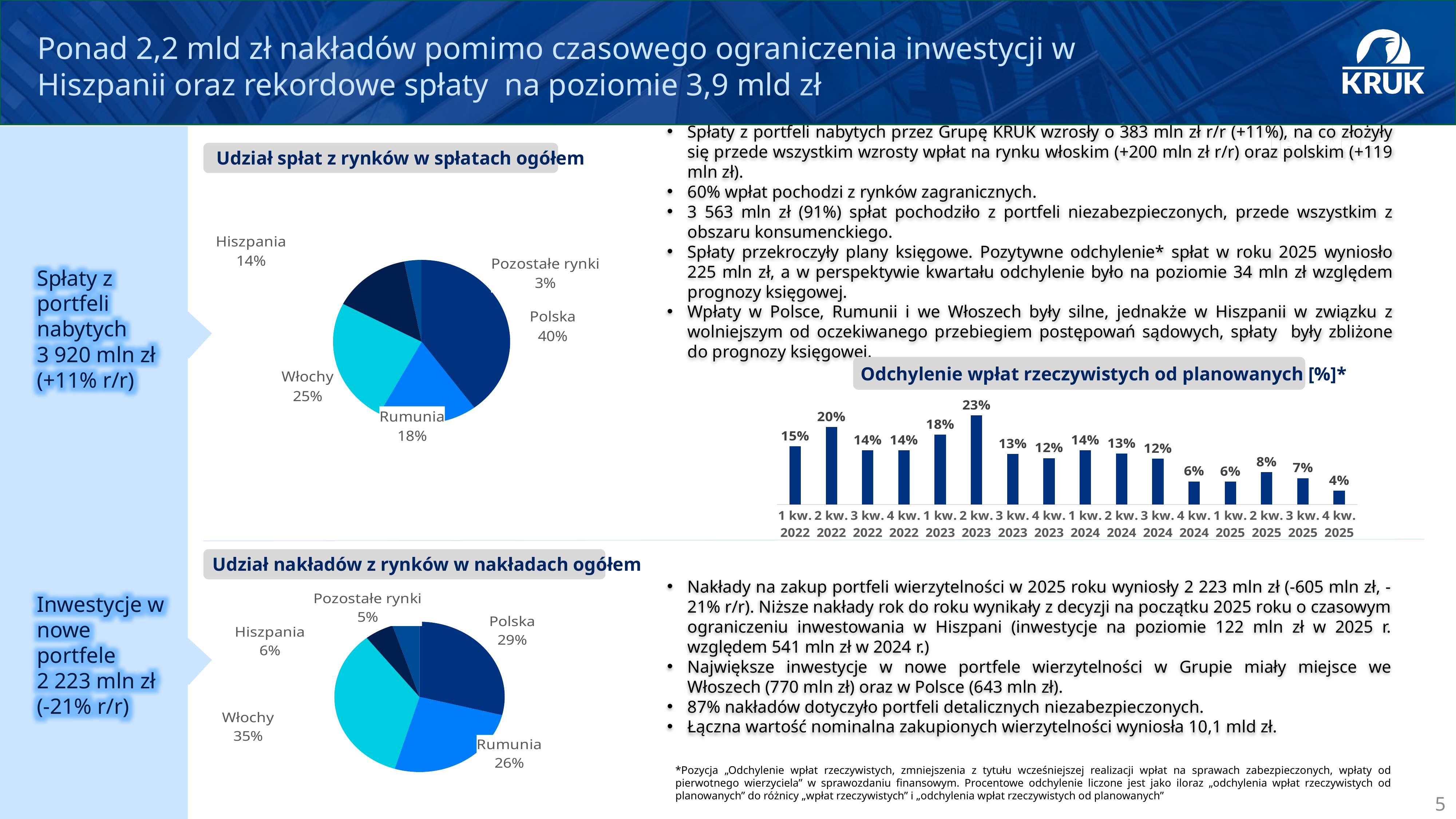
In the chart 'Odchylenie wpłat rzeczywistych od planowanych [%]*', how many quarters are shown? 16 What kind of chart is 'Odchylenie wpłat rzeczywistych od planowanych [%]*'? Bar chart In the chart 'Odchylenie wpłat rzeczywistych od planowanych [%]*', what is the difference between the values for 1 kw. 2022 and 1 kw. 2025? 9 percentage points In the chart 'Udział nakładów z rynków w nakładach ogółem', which is larger: the share of Polska or the share of Rumunia? Polska In the chart 'Udział nakładów z rynków w nakładach ogółem', what share does Hiszpania have? 6% In the chart 'Udział spłat z rynków w spłatach ogółem', what share does Polska have? 40% In the chart 'Odchylenie wpłat rzeczywistych od planowanych [%]*', what is the value for 4 kw. 2025? 4% In the chart 'Odchylenie wpłat rzeczywistych od planowanych [%]*', which quarter has the highest value? 2 kw. 2023 In the chart 'Udział spłat z rynków w spłatach ogółem', which market has the smallest share? Pozostałe rynki In the chart 'Udział nakładów z rynków w nakładach ogółem', which market has the largest share? Włochy In the chart 'Udział spłat z rynków w spłatach ogółem', what is the difference between the shares of Włochy and Rumunia? 7 percentage points In the chart 'Udział spłat z rynków w spłatach ogółem', how many slices does the pie have? 5